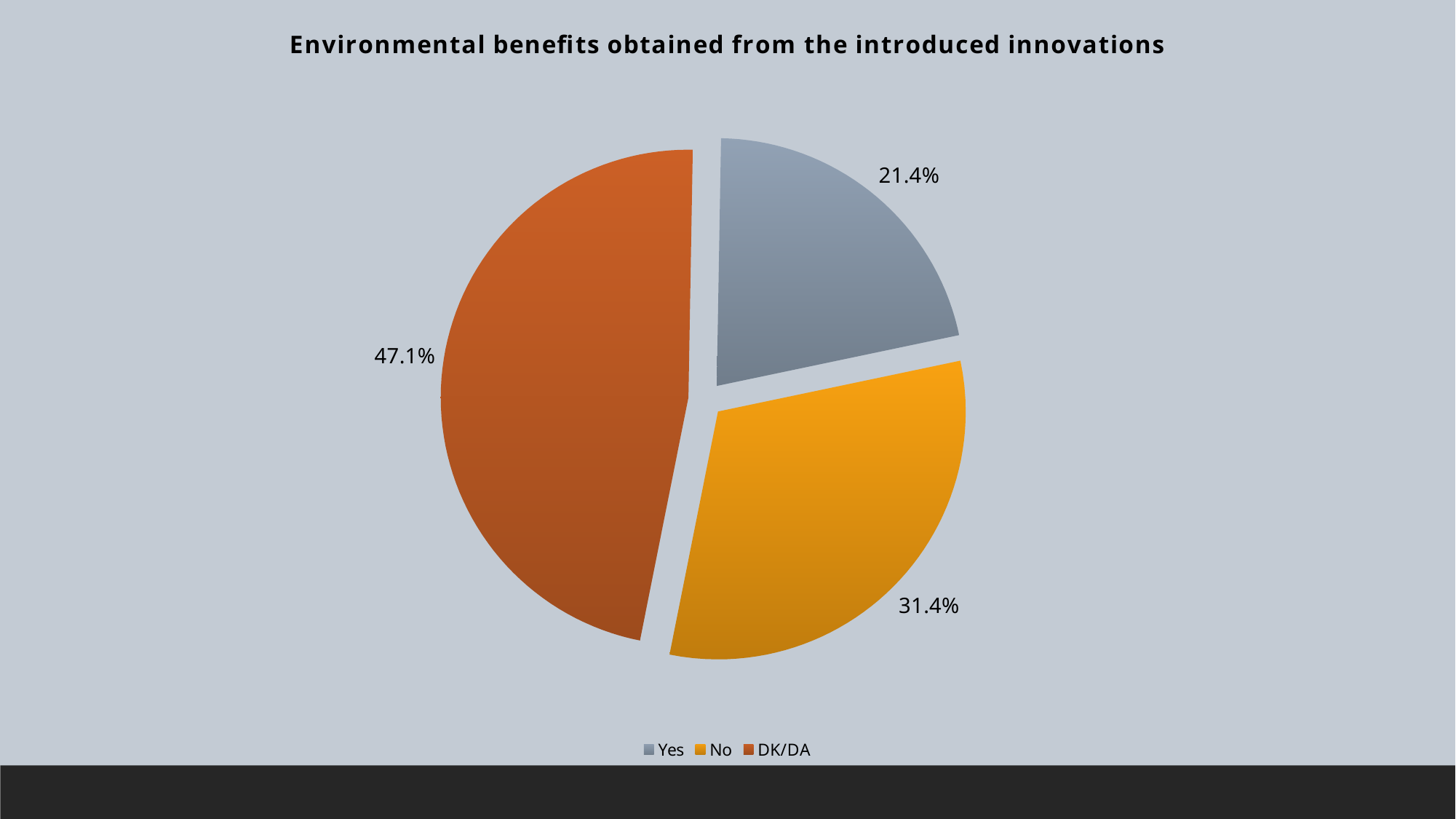
What is the title of the chart? Environmental benefits obtained from the introduced innovations What is the difference in percentage points between the DK/DA slice and the Yes slice? 25.7 What kind of chart is shown on the slide? Pie chart Which category has the largest slice of the pie? DK/DA What is the difference in percentage points between the No slice and the Yes slice? 10 What share of the pie is labelled "Yes"? 21.4% Which category has the smallest slice of the pie? Yes Which colour represents the "No" category in the legend? Orange/yellow Which slice is larger, No or Yes? No How many categories does the pie chart show? 3 What share of the pie is labelled "No"? 31.4% What share of the pie is labelled "DK/DA"? 47.1%